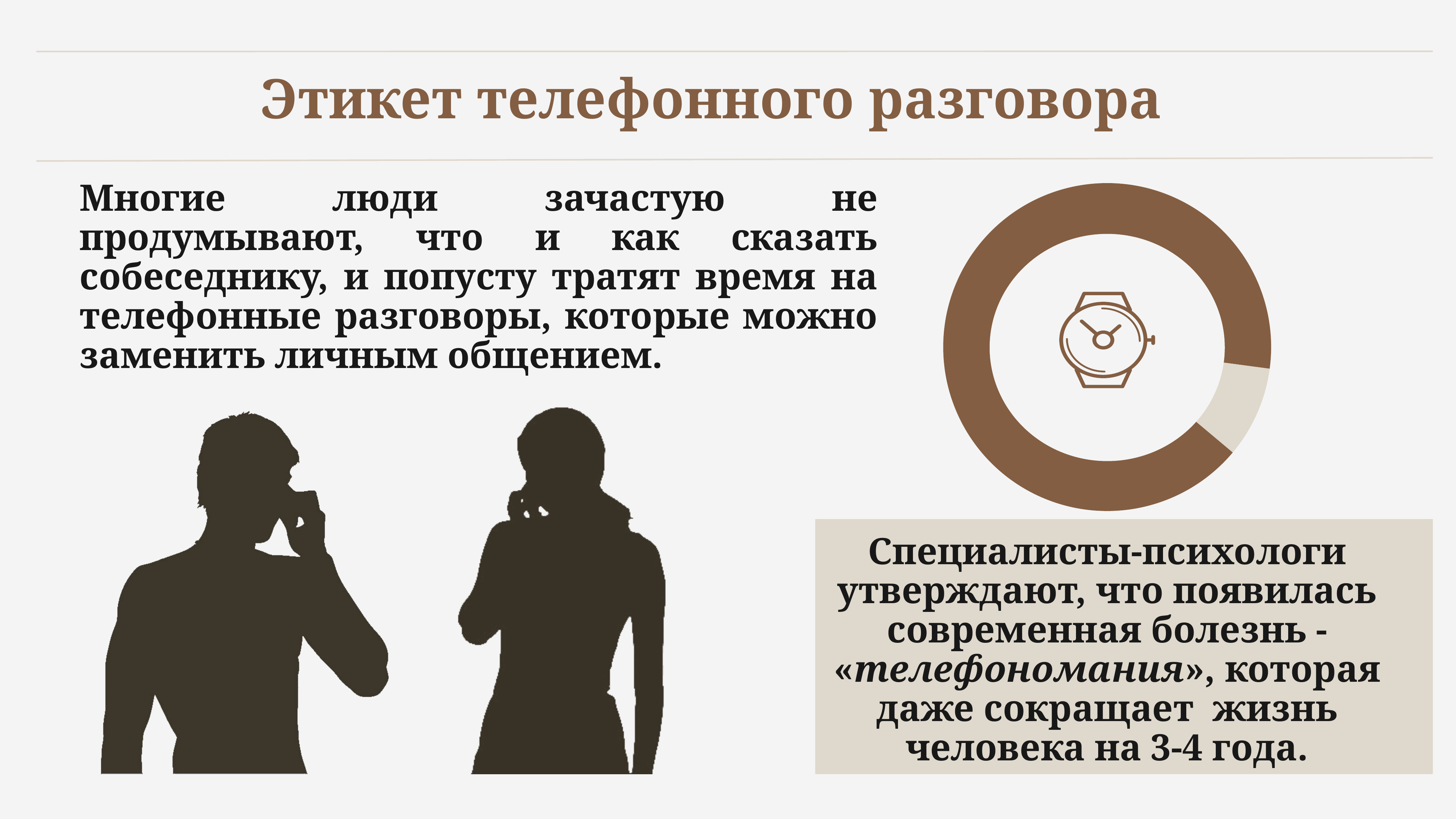
How many slices does the doughnut chart on the right side of the slide have? 2 In the doughnut chart on the right side of the slide, which slice is larger, the dark brown one or the light beige one? the dark brown one What icon is placed in the centre of the doughnut chart on the right side of the slide? a wristwatch What kind of chart is shown on the right side of the slide, around the watch icon? doughnut chart Does the doughnut chart on the right side of the slide show a legend? No